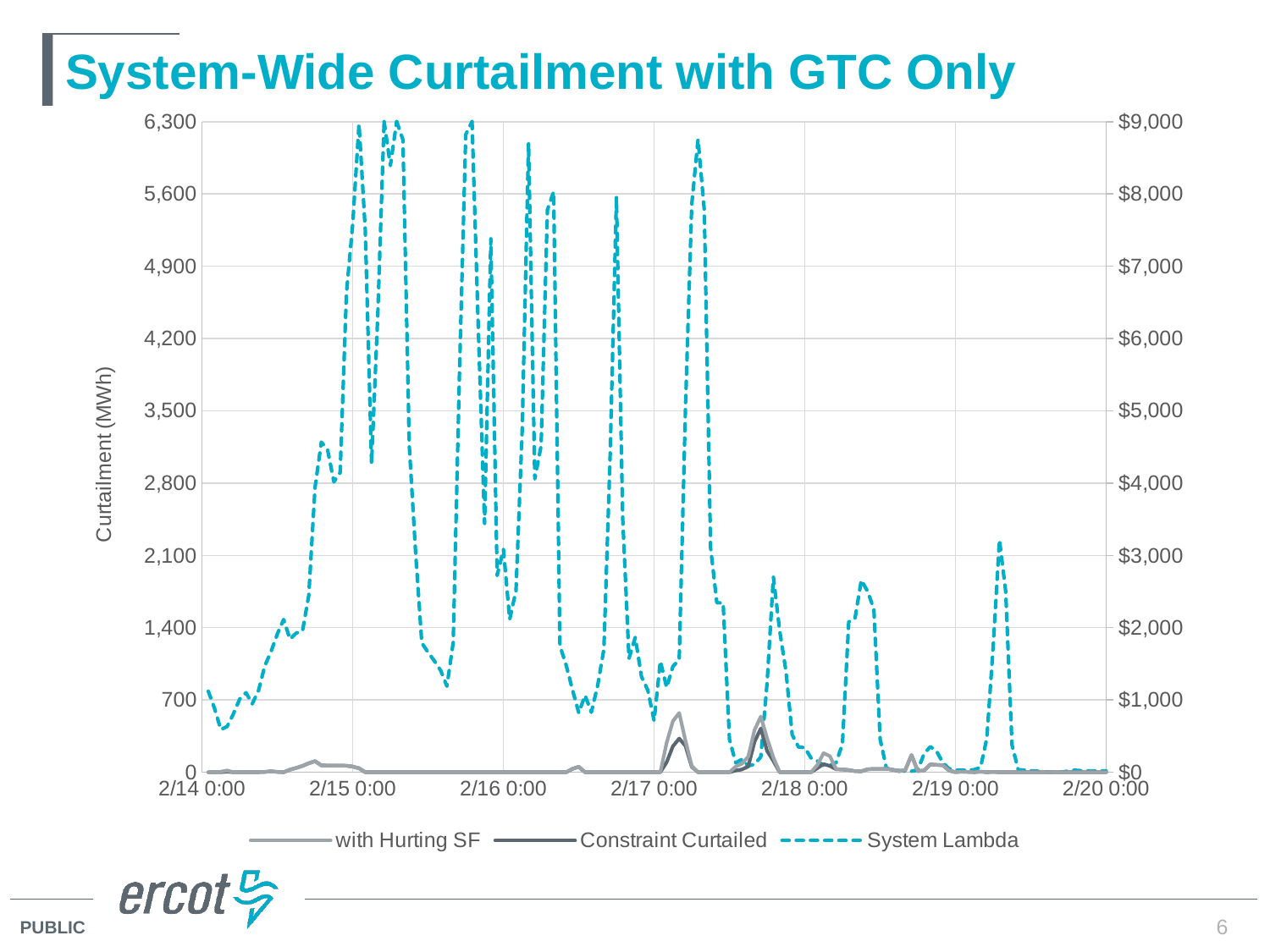
How many date labels are shown on the x axis? 7 At the peak near 2/17, which series is higher: 'with Hurting SF' or 'Constraint Curtailed'? with Hurting SF What is the title of the chart? System-Wide Curtailment with GTC Only Is the highest value of the System Lambda series greater or less than $8,000? greater What is the label of the left vertical axis? Curtailment (MWh) Is the System Lambda peak just before 2/18 0:00 greater or less than $3,000? less Is the peak of the 'Constraint Curtailed' series near 2/17 greater or less than 700 MWh? less Does the System Lambda series generally rise or fall between 2/14 0:00 and 2/15 0:00? rise What kind of chart is shown on the slide? Line chart Which series is drawn with a dashed line? System Lambda How many series does the legend list? 3